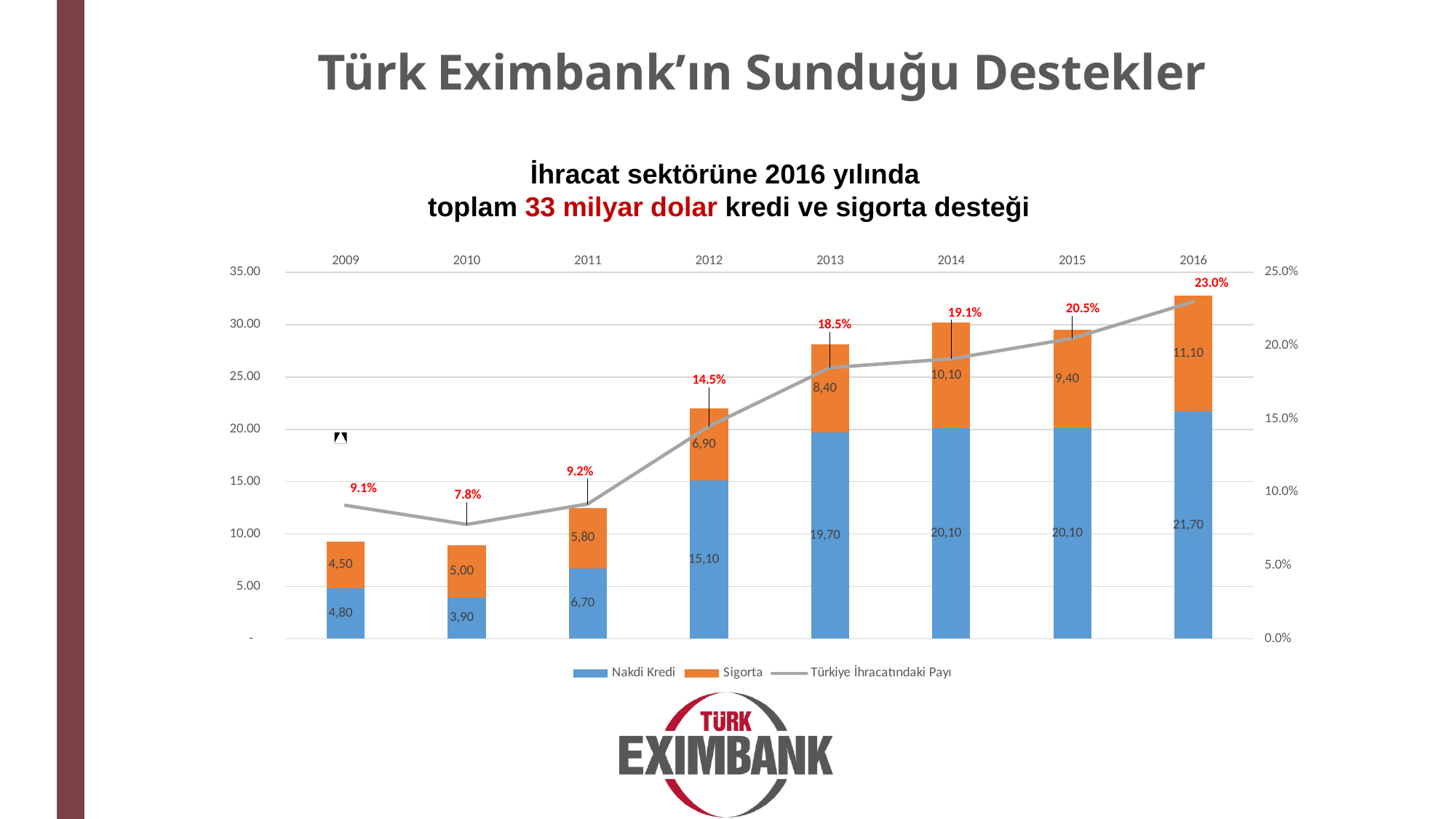
In which year is the Türkiye İhracatındaki Payı line at its lowest? 2010 What is the Nakdi Kredi value for 2016? 21,70 Which is larger, the Sigorta value for 2014 or for 2015? 2014 What is the difference between the Nakdi Kredi values for 2016 and 2015? 1,60 Does the Türkiye İhracatındaki Payı line generally rise or fall from 2010 to 2016? rise What is the Türkiye İhracatındaki Payı value for 2012? 14.5% Which series is shown in orange? Sigorta What is the Sigorta value for 2013? 8,40 In which year is the Sigorta value highest? 2016 How many series does the legend list? 3 What is the total of the stacked bar for 2016? 32,80 How many years are shown on the x axis? 8